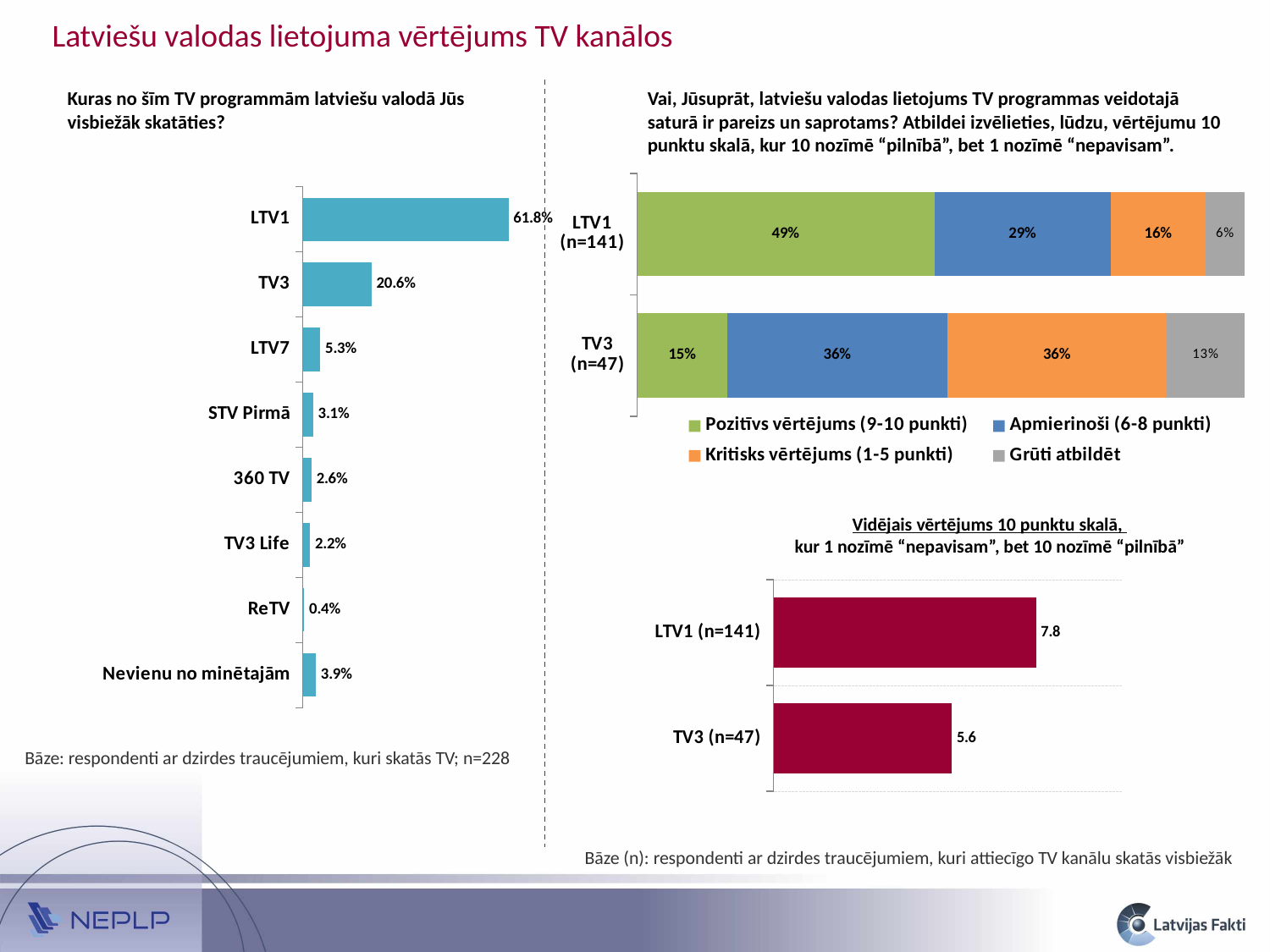
In the bottom-right chart (Vidējais vērtējums 10 punktu skalā), what is the value for TV3 (n=47)? 5.6 In the left chart (Kuras no šīm TV programmām latviešu valodā Jūs visbiežāk skatāties?), how many categories are shown? 8 In the left chart (Kuras no šīm TV programmām latviešu valodā Jūs visbiežāk skatāties?), what is the difference between the values for LTV1 and TV3? 41.2% In the top-right stacked bar chart, what is the difference between the Kritisks vērtējums (1-5 punkti) shares for TV3 (n=47) and LTV1 (n=141)? 20% In the left chart (Kuras no šīm TV programmām latviešu valodā Jūs visbiežāk skatāties?), which is larger: the value for STV Pirmā or the value for Nevienu no minētajām? Nevienu no minētajām What kind of chart is the bottom-right chart (Vidējais vērtējums 10 punktu skalā)? Bar chart In the top-right stacked bar chart, what is the share of Pozitīvs vērtējums (9-10 punkti) for LTV1 (n=141)? 49% In the top-right stacked bar chart, how many series does the legend list? 4 In the left chart (Kuras no šīm TV programmām latviešu valodā Jūs visbiežāk skatāties?), what is the value for LTV1? 61.8% In the top-right stacked bar chart, what is the share of Grūti atbildēt for TV3 (n=47)? 13% In the bottom-right chart (Vidējais vērtējums 10 punktu skalā), what is the difference between the values for LTV1 (n=141) and TV3 (n=47)? 2.2 In the left chart (Kuras no šīm TV programmām latviešu valodā Jūs visbiežāk skatāties?), which category has the lowest value? ReTV